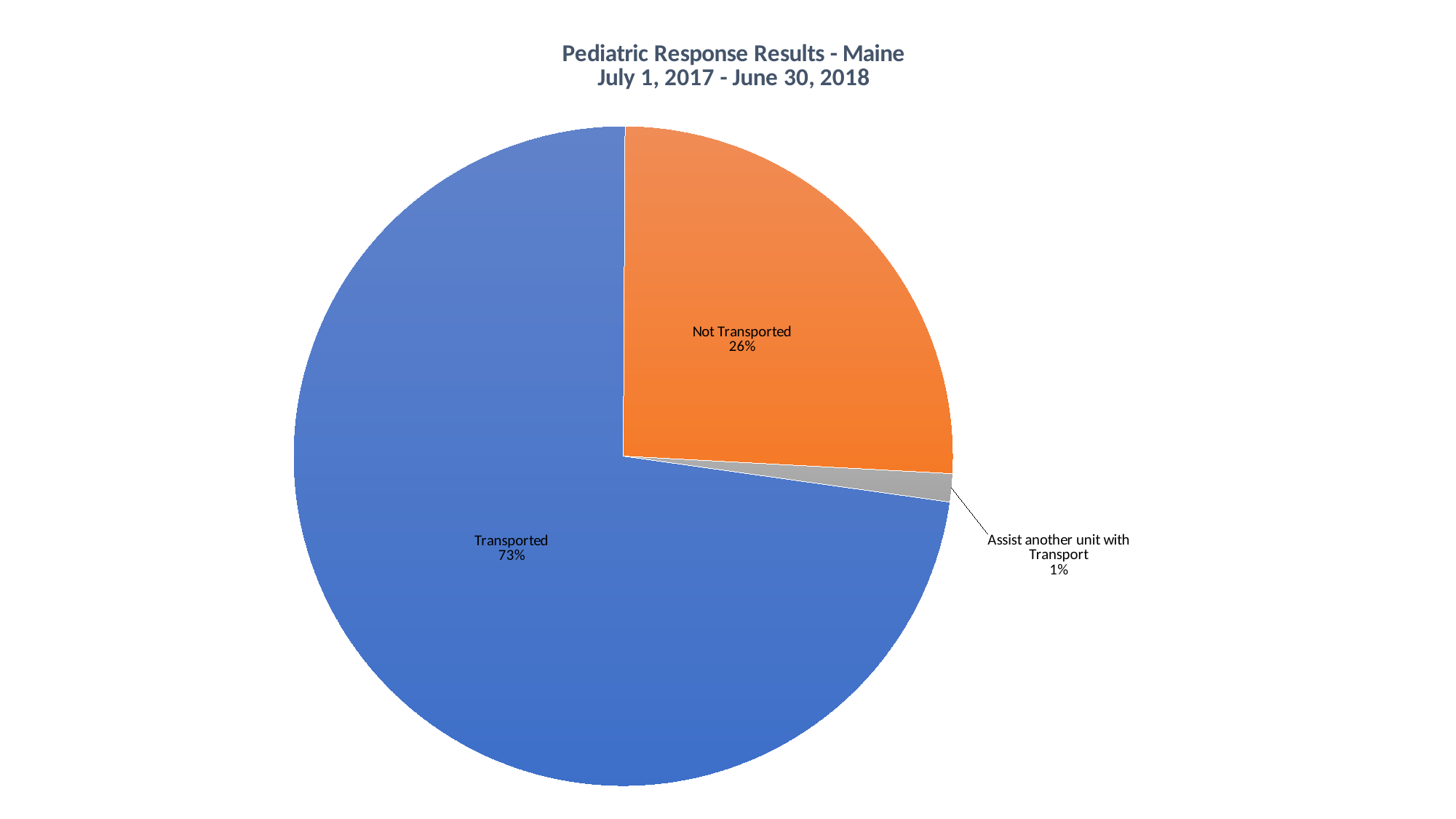
How many slices does the pie chart have? 3 Which category has the smallest slice? Assist another unit with Transport What is the difference in percentage points between Not Transported and Assist another unit with Transport? 25 What share of the pie is Not Transported? 26% Which category has the largest slice? Transported What is the title of the chart? Pediatric Response Results - Maine July 1, 2017 - June 30, 2018 What is the difference in percentage points between Transported and Not Transported? 47 What kind of chart is shown on the slide? pie chart What share of the pie is Transported? 73% Which is larger, Not Transported or Assist another unit with Transport? Not Transported What share of the pie is Assist another unit with Transport? 1% What colour is the Transported slice? blue